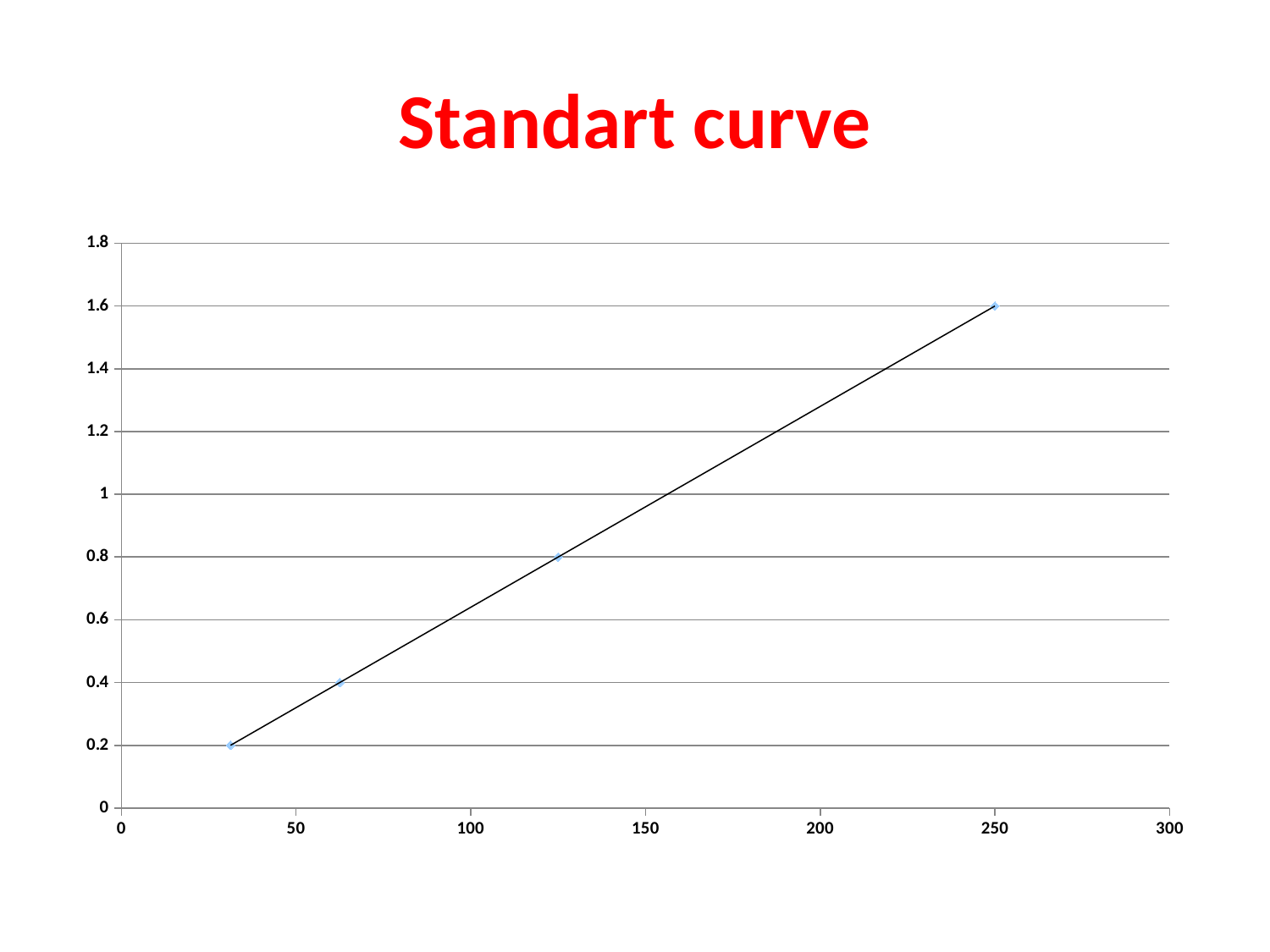
Do the values rise or fall as you move along the x axis? rise What is the title of the chart? Standart curve What is the y value of the highest point on the chart? 1.6 What is the highest value shown on the y axis? 1.8 Which point has the larger y value: the point at x = 250 or the leftmost point? the point at x = 250 What is the y value of the point at x = 250? 1.6 What kind of chart is shown on the slide? line chart What is the difference between the y values of the highest and lowest points? 1.4 What is the y value of the lowest point on the chart? 0.2 How many data points are plotted on the chart? 4 Is the y value of the third point from the left greater or less than 1? less Is the y value of the second point from the left greater or less than 0.6? less